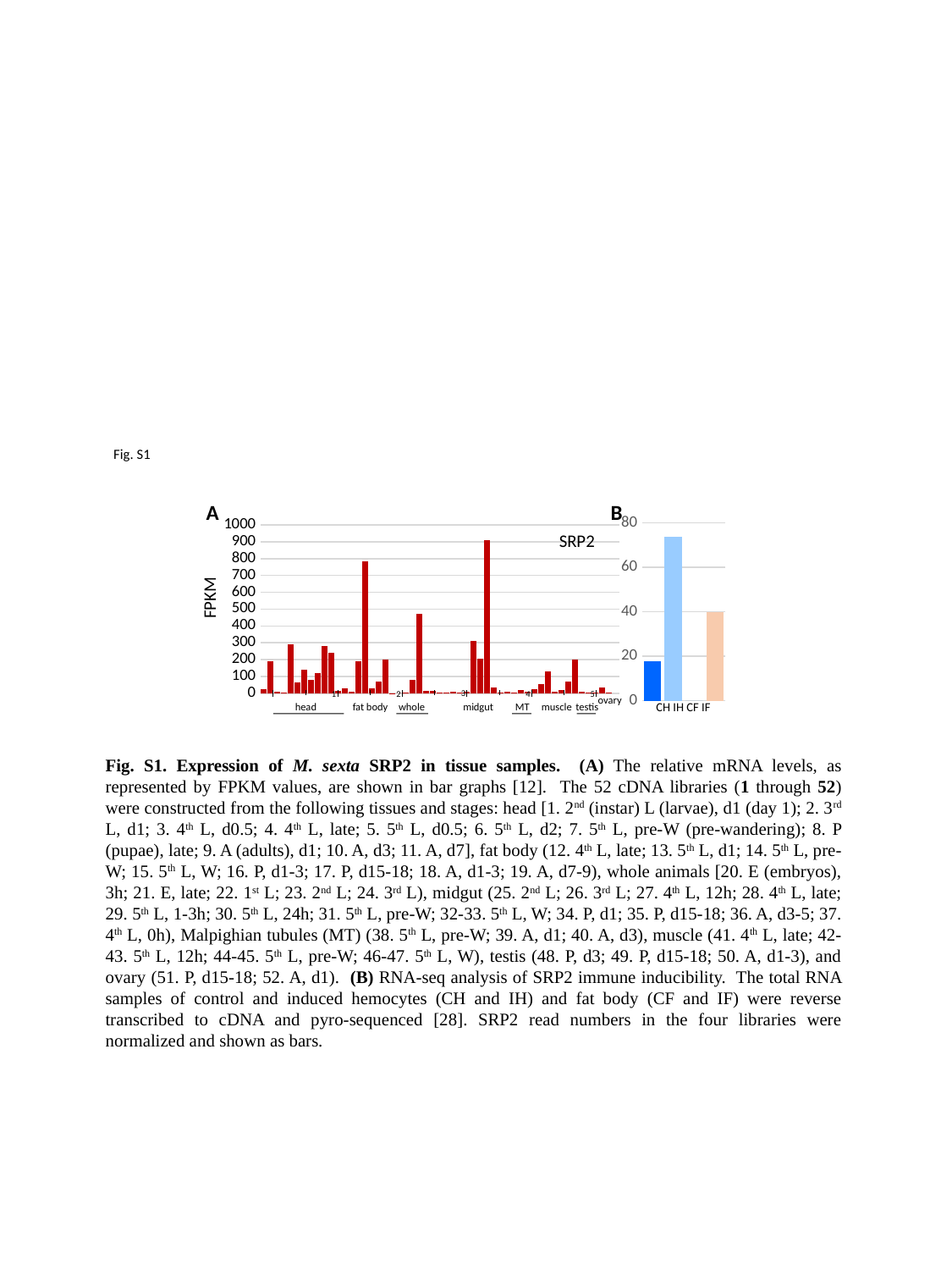
In chart B (the right chart), is the value for CH greater or less than 20? less In chart A (the left chart), is the tallest bar in the midgut group greater or less than 800? greater In chart A (the left chart), is the tallest bar in the fat body group greater or less than 700? greater In chart A (the left chart), what is the label on the y axis? FPKM What kind of chart is chart A (the left chart)? bar chart In chart B (the right chart), which is larger, the value for IH or the value for IF? IH In chart A (the left chart), how many tissue groups are labelled along the x axis? 8 In chart B (the right chart), which category has the highest bar? IH In chart A (the left chart), which tissue group contains the tallest bar? midgut In chart A (the left chart), what gene name is printed inside the plot area? SRP2